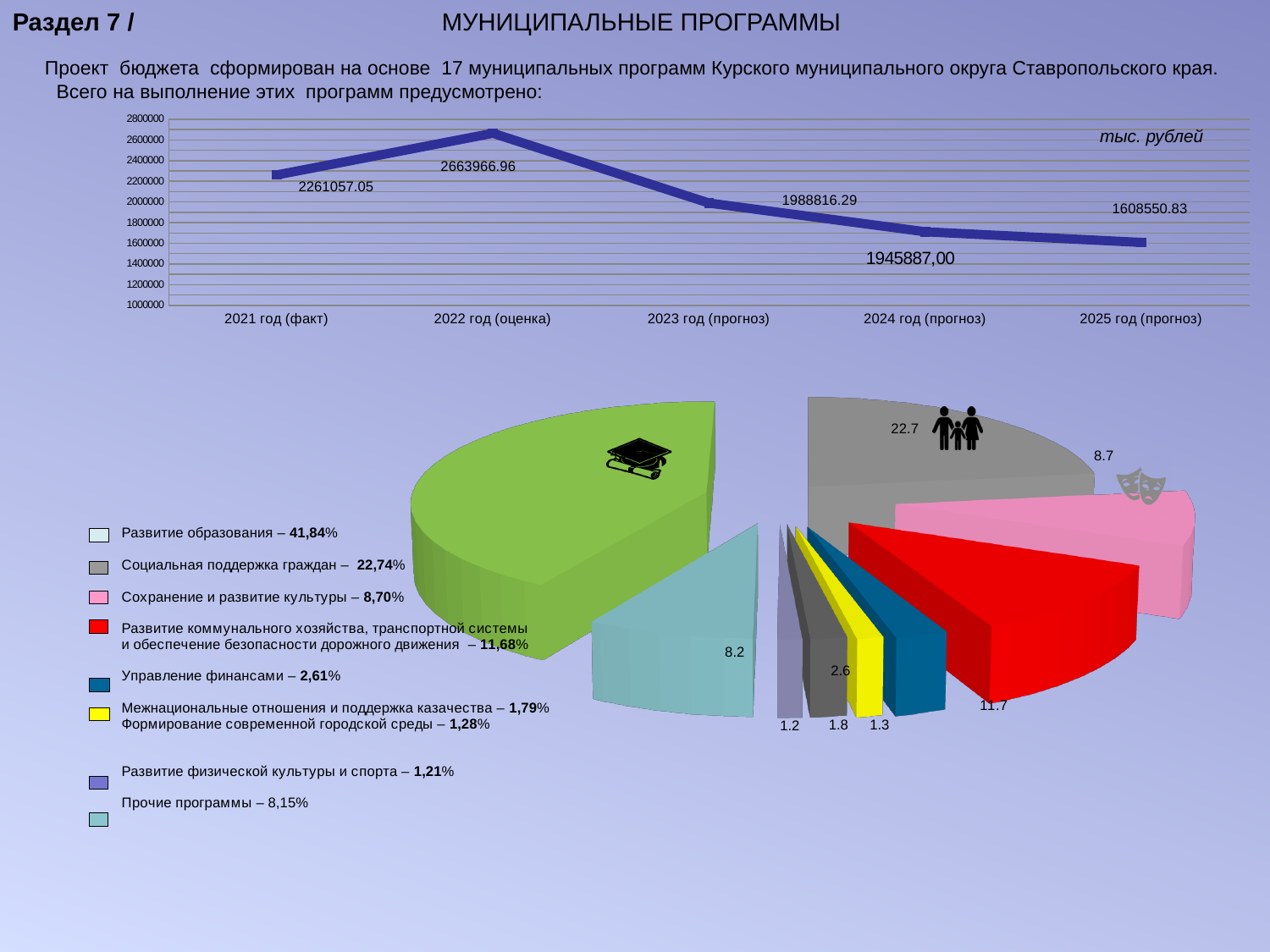
On the top line chart, which year has the lowest value? 2025 год (прогноз) What kind of chart is the bottom chart on the slide? Pie chart On the top line chart, how many data points are plotted? 5 On the bottom pie chart, what share does Социальная поддержка граждан have according to the legend? 22,74% On the top line chart, which is larger: the value for 2023 год (прогноз) or 2024 год (прогноз)? 2023 год (прогноз) On the top line chart, which year has the highest value? 2022 год (оценка) On the top line chart, do the values rise or fall from 2022 год (оценка) to 2025 год (прогноз)? Fall On the top line chart, what is the difference between the values for 2022 год (оценка) and 2021 год (факт)? 402909.91 On the top line chart, what is the value for 2025 год (прогноз)? 1608550.83 What kind of chart is the top chart on the slide? Line chart On the top line chart, what is the value for 2022 год (оценка)? 2663966.96 On the bottom pie chart, which program has the largest share? Развитие образования